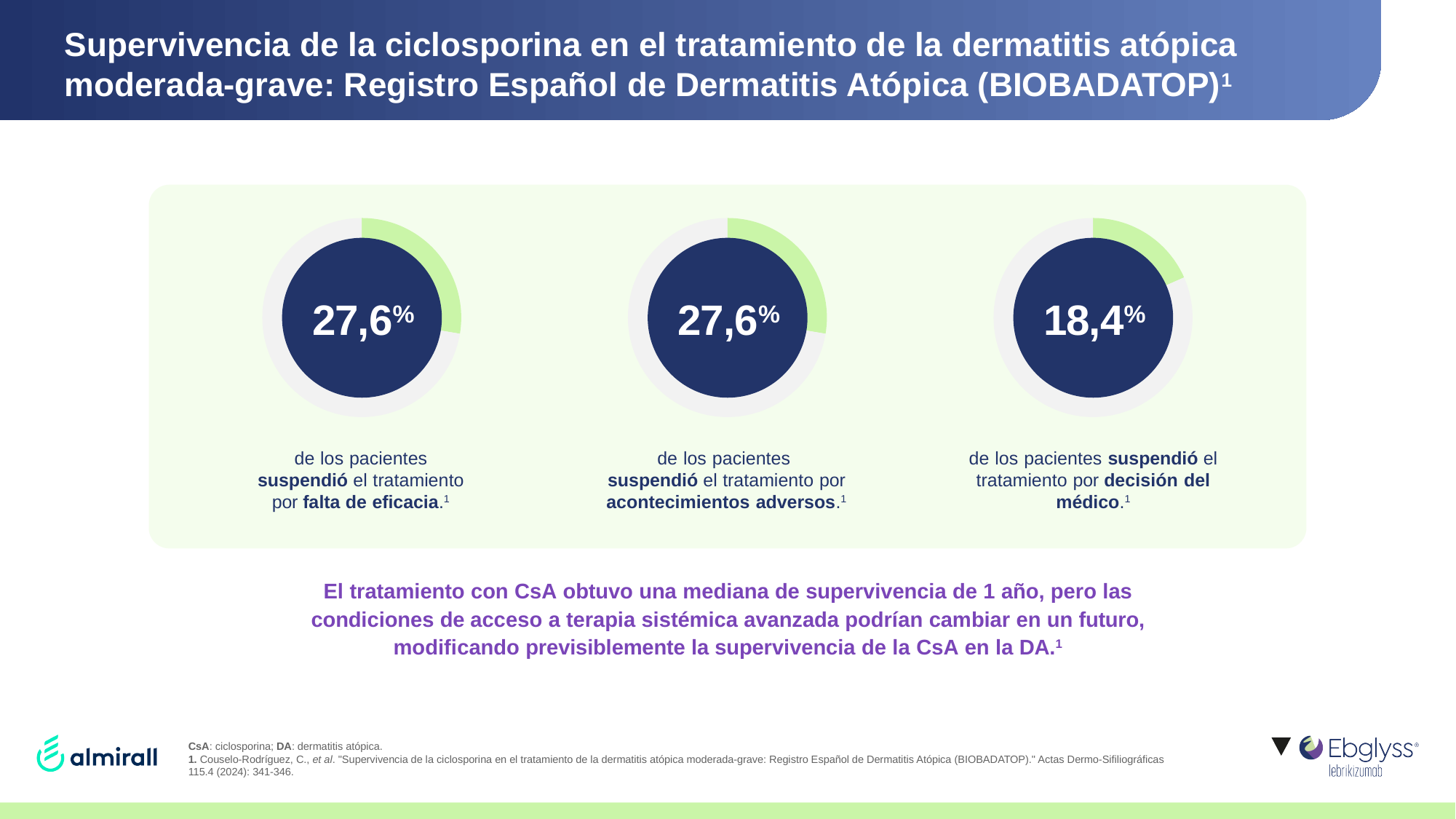
Do the left chart (falta de eficacia) and the middle chart (acontecimientos adversos) show the same percentage? Yes, both 27,6% What kind of chart is used to display the percentages on the slide? Donut chart What is the difference in percentage points between the left chart (falta de eficacia) and the right chart (decisión del médico)? 9,2 What does the right chart's 18,4% represent? Patients who discontinued treatment by physician decision (decisión del médico) How many circular charts are shown on the slide? 3 On the right chart, what percentage of patients discontinued treatment by physician decision (decisión del médico)? 18,4% On the left chart, what percentage of patients discontinued treatment due to lack of efficacy (falta de eficacia)? 27,6% On the middle chart, what percentage of patients discontinued treatment due to adverse events (acontecimientos adversos)? 27,6% Which is larger: the percentage for falta de eficacia (left chart) or for decisión del médico (right chart)? falta de eficacia Across the three charts, which reason for discontinuation has the lowest percentage? decisión del médico What colour is the filled arc on each donut chart? Green